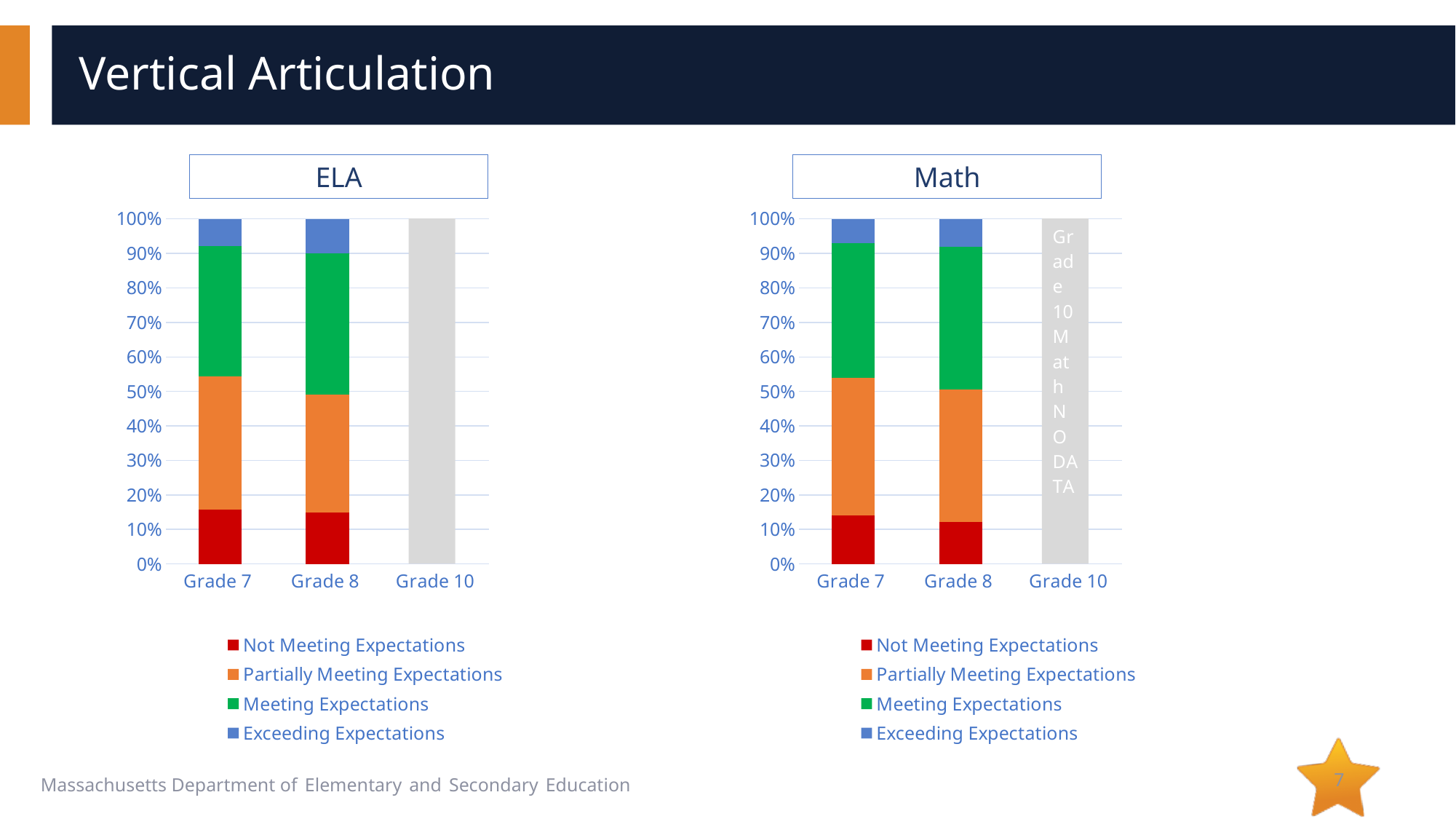
In the ELA chart, is the top of the Meeting Expectations segment for Grade 8 above or below 80%? above What is the highest value shown on the y axis of the Math chart? 100% In the ELA chart, is the Not Meeting Expectations value for Grade 7 greater or less than 20%? less How many grade categories are shown on the x axis of the Math chart? 3 In the Math chart, is the top of the Partially Meeting Expectations segment for Grade 7 above or below 60%? below What kind of chart is the ELA chart? Stacked bar chart What is the title of the chart on the right side of the slide? Math Which legend entry in the ELA chart is shown in red? Not Meeting Expectations How many series does the legend of the ELA chart list? 4